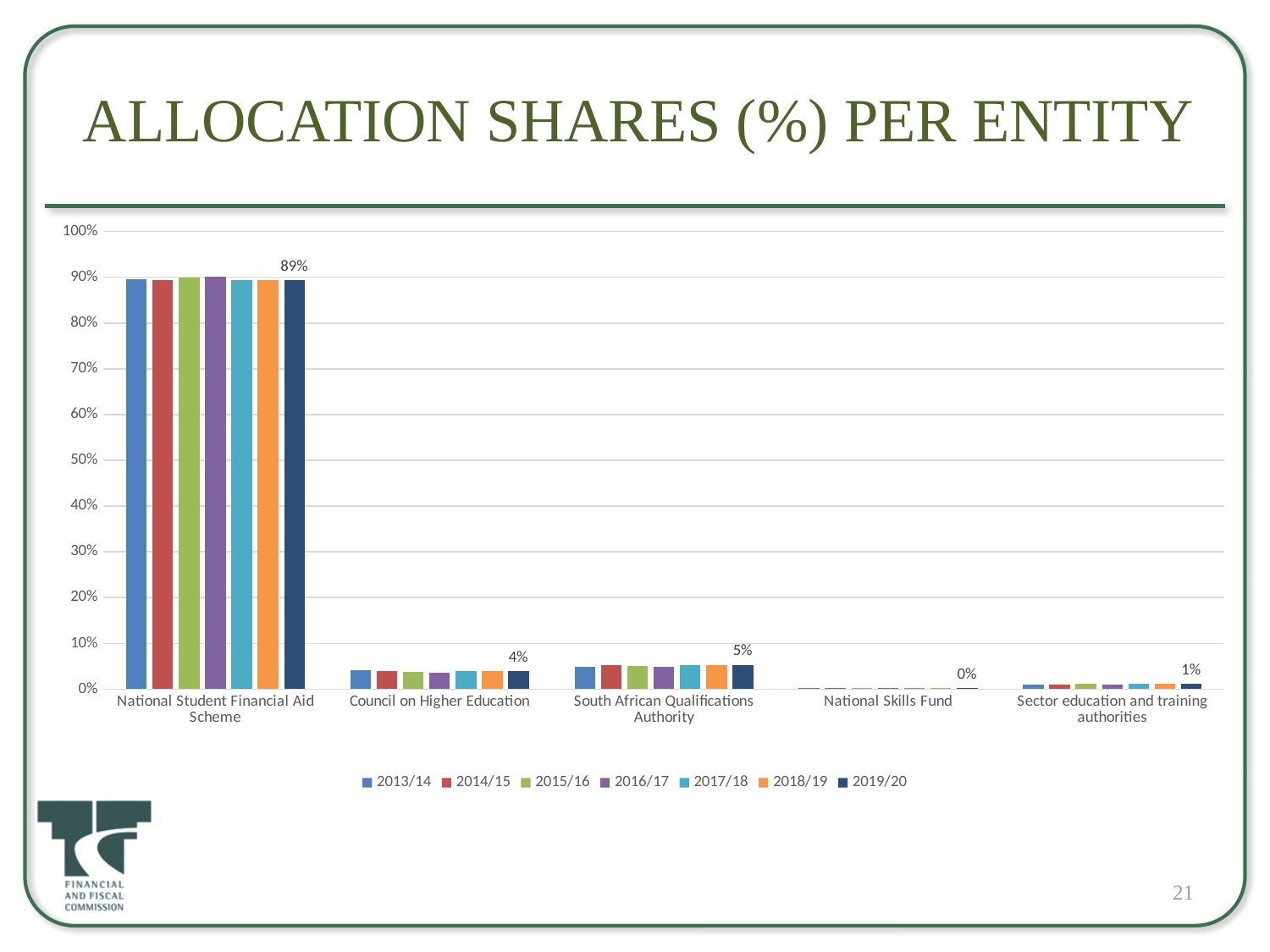
How many entities are shown on the x axis? 5 What is the 2019/20 allocation share for the South African Qualifications Authority? 5% How many series does the legend list? 7 In 2019/20, which has the larger allocation share: the Council on Higher Education or the South African Qualifications Authority? South African Qualifications Authority What is the 2019/20 allocation share for the Council on Higher Education? 4% What is the 2019/20 allocation share for Sector education and training authorities? 1% Which entity has the lowest allocation share? National Skills Fund What is the 2019/20 allocation share for the National Student Financial Aid Scheme? 89% Is the 2013/14 value for the National Student Financial Aid Scheme greater or less than 80%? greater What is the 2019/20 allocation share for the National Skills Fund? 0% Which entity has the highest allocation share? National Student Financial Aid Scheme What is the difference between the 2019/20 shares of the National Student Financial Aid Scheme and the South African Qualifications Authority? 84%